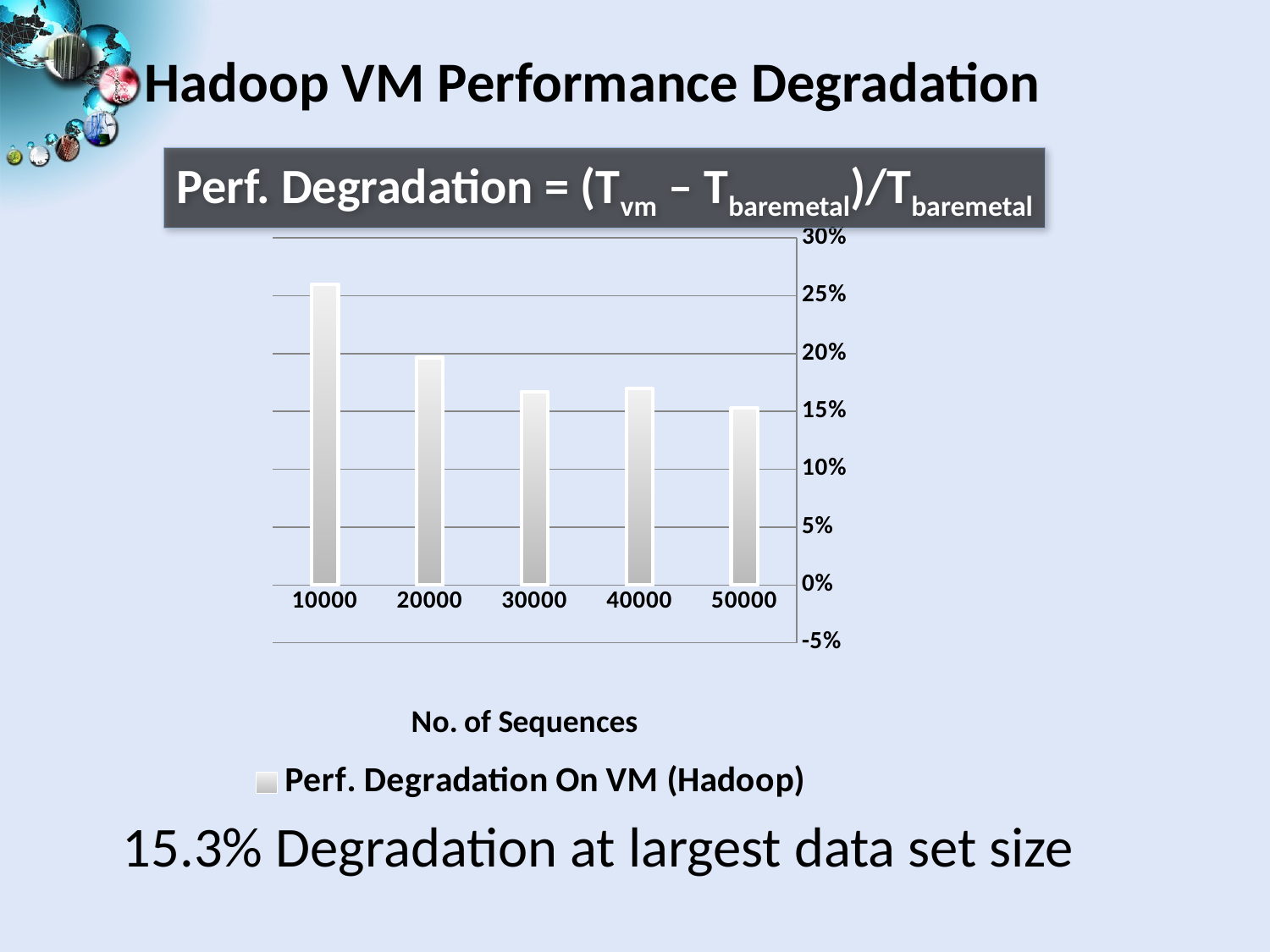
What is the title of the x axis of the chart? No. of Sequences Which number of sequences has the lowest performance degradation? 50000 Which has the larger performance degradation, 10000 sequences or 20000 sequences? 10000 How many series does the legend list? 1 What kind of chart is shown on the slide? bar chart Is the performance degradation for 40000 sequences greater or less than 15%? greater Is the performance degradation for 30000 sequences greater or less than 20%? less Is the performance degradation for 50000 sequences greater or less than 20%? less Does the performance degradation generally rise or fall as the number of sequences increases? fall How many categories (numbers of sequences) are plotted on the x axis? 5 Which number of sequences has the highest performance degradation? 10000